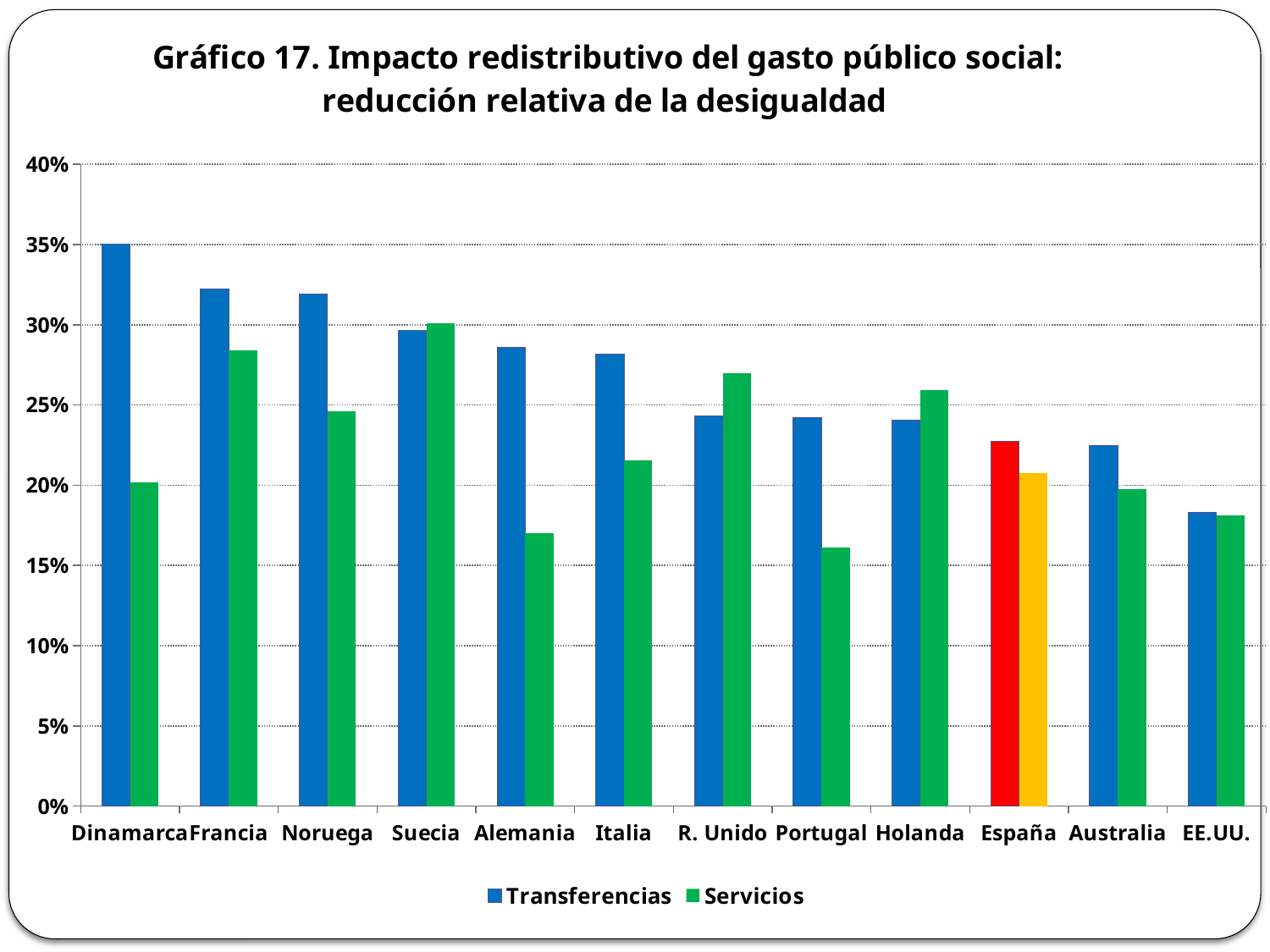
How many countries are shown on the x axis? 12 Is the value for Transferencias in Dinamarca greater or less than 30%? greater Is the value for Servicios in Portugal greater or less than 20%? less For Alemania, which is larger: Transferencias or Servicios? Transferencias Which country has the lowest value for Transferencias? EE.UU. Do the Transferencias values generally rise or fall from left to right along the x axis? fall How many series does the legend list? 2 Is the value for Servicios in Alemania greater or less than 20%? less Which country's bars are coloured red and yellow instead of blue and green? España What kind of chart is shown on the slide? bar chart Which country has the highest value for Servicios? Suecia Which country has the highest value for Transferencias? Dinamarca